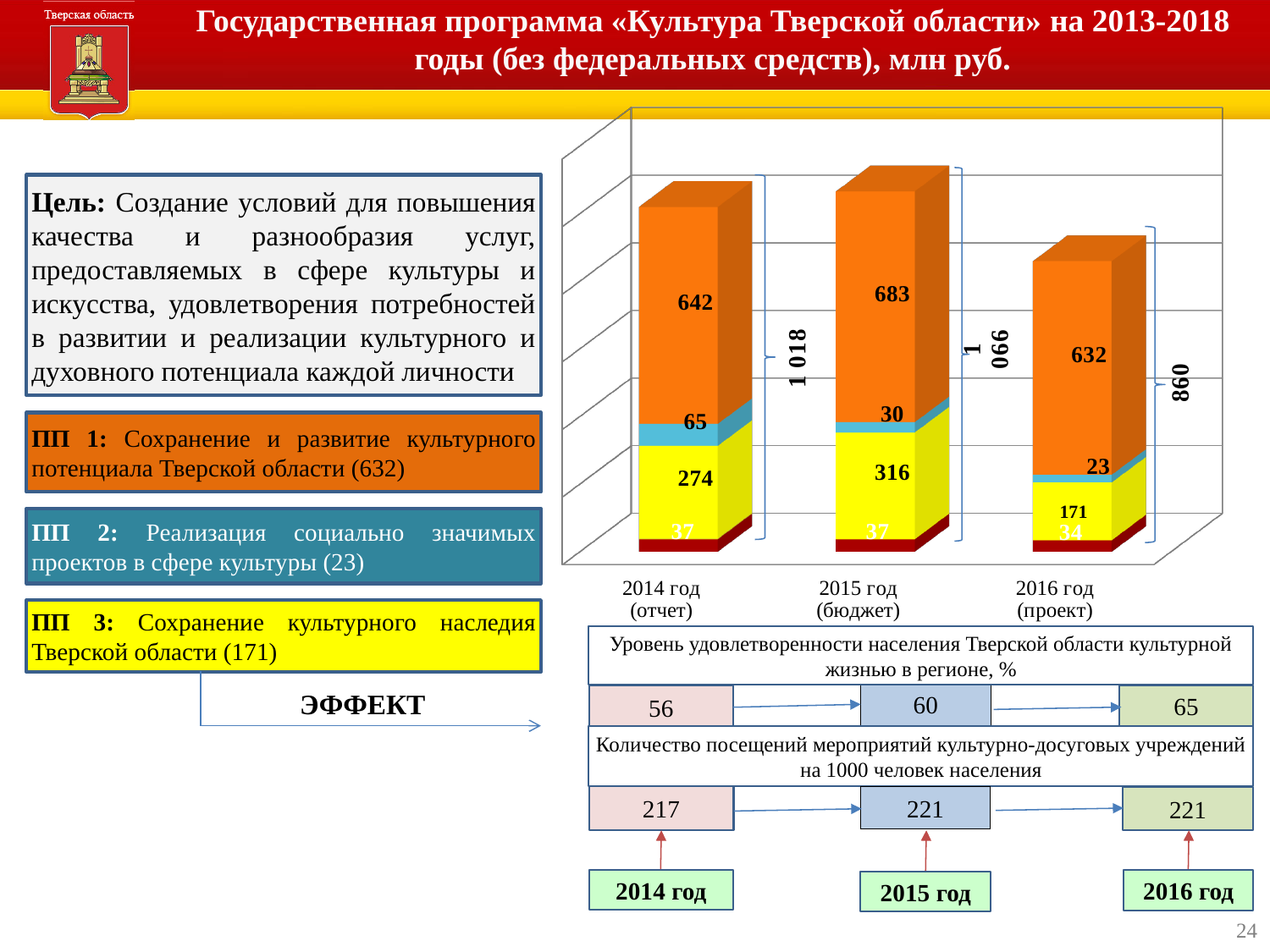
What is the total value shown for the 2015 год (бюджет) bar? 1 066 What is the value of the blue segment in the 2016 год (проект) bar? 23 What is the total value shown for the 2014 год (отчет) bar? 1 018 What type of chart is shown on the slide? stacked bar chart Which year has the lowest total value in the chart? 2016 год (проект) Which year has the highest total value in the chart? 2015 год (бюджет) How many bars (years) are plotted in the chart? 3 What is the total value shown for the 2016 год (проект) bar? 860 What is the value of the orange segment in the 2015 год (бюджет) bar? 683 What is the value of the yellow segment in the 2014 год (отчет) bar? 274 Which is larger: the orange segment for 2014 год (отчет) or the orange segment for 2016 год (проект)? 2014 год (отчет) What is the difference between the yellow segment values for 2015 год (бюджет) and 2016 год (проект)? 145